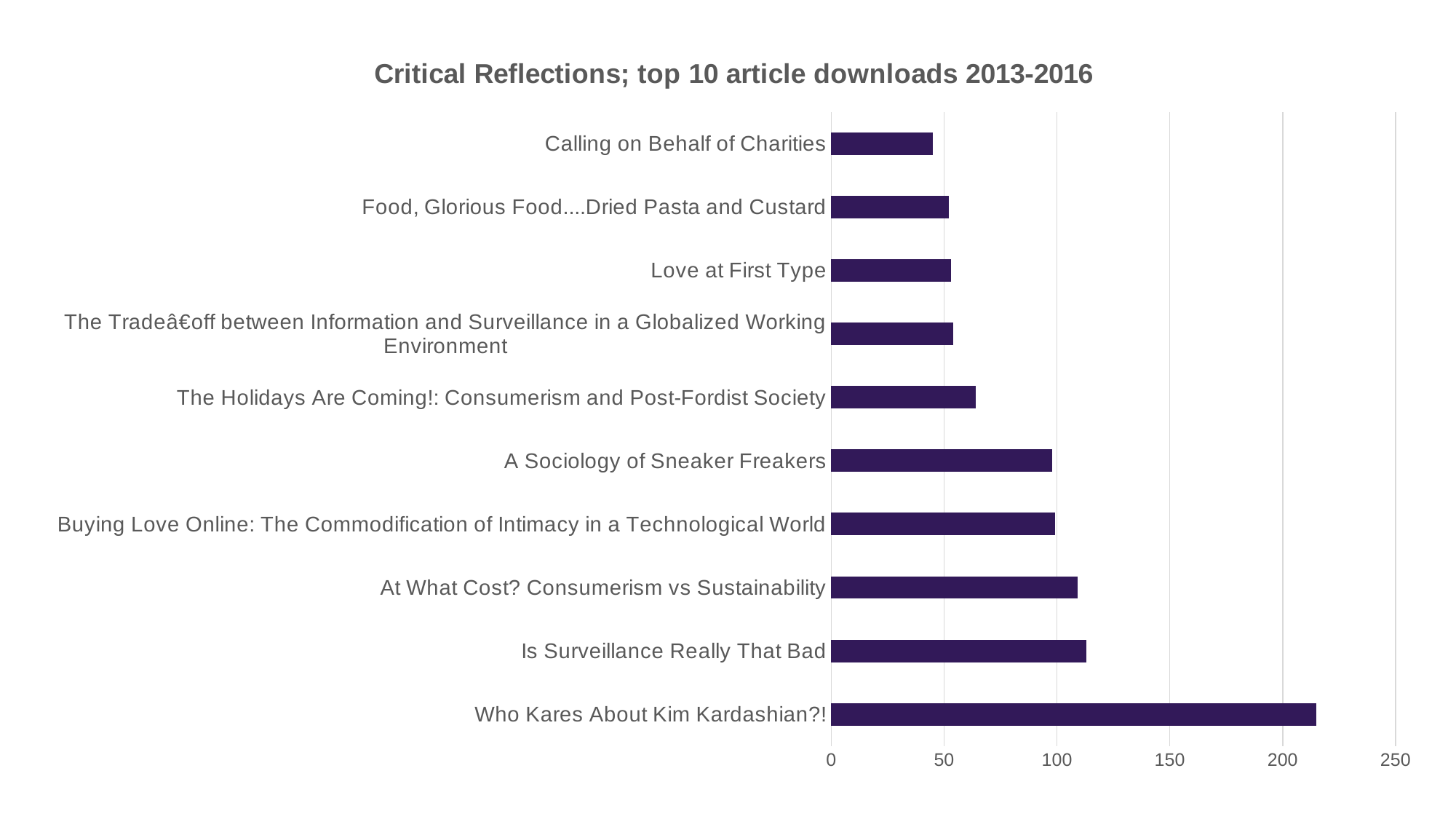
How many articles are listed in the chart? 10 Is the value for Is Surveillance Really That Bad greater or less than 100? greater Which article has the highest number of downloads? Who Kares About Kim Kardashian?! Is the value for Calling on Behalf of Charities greater or less than 50? less Which has more downloads: Who Kares About Kim Kardashian?! or Is Surveillance Really That Bad? Who Kares About Kim Kardashian?! Is the value for Who Kares About Kim Kardashian?! greater or less than 200? greater What is the title of the chart? Critical Reflections; top 10 article downloads 2013-2016 What kind of chart is shown on the slide? bar chart Which article has the lowest number of downloads? Calling on Behalf of Charities Which has more downloads: A Sociology of Sneaker Freakers or The Holidays Are Coming!: Consumerism and Post-Fordist Society? A Sociology of Sneaker Freakers What is the highest value shown on the horizontal axis? 250